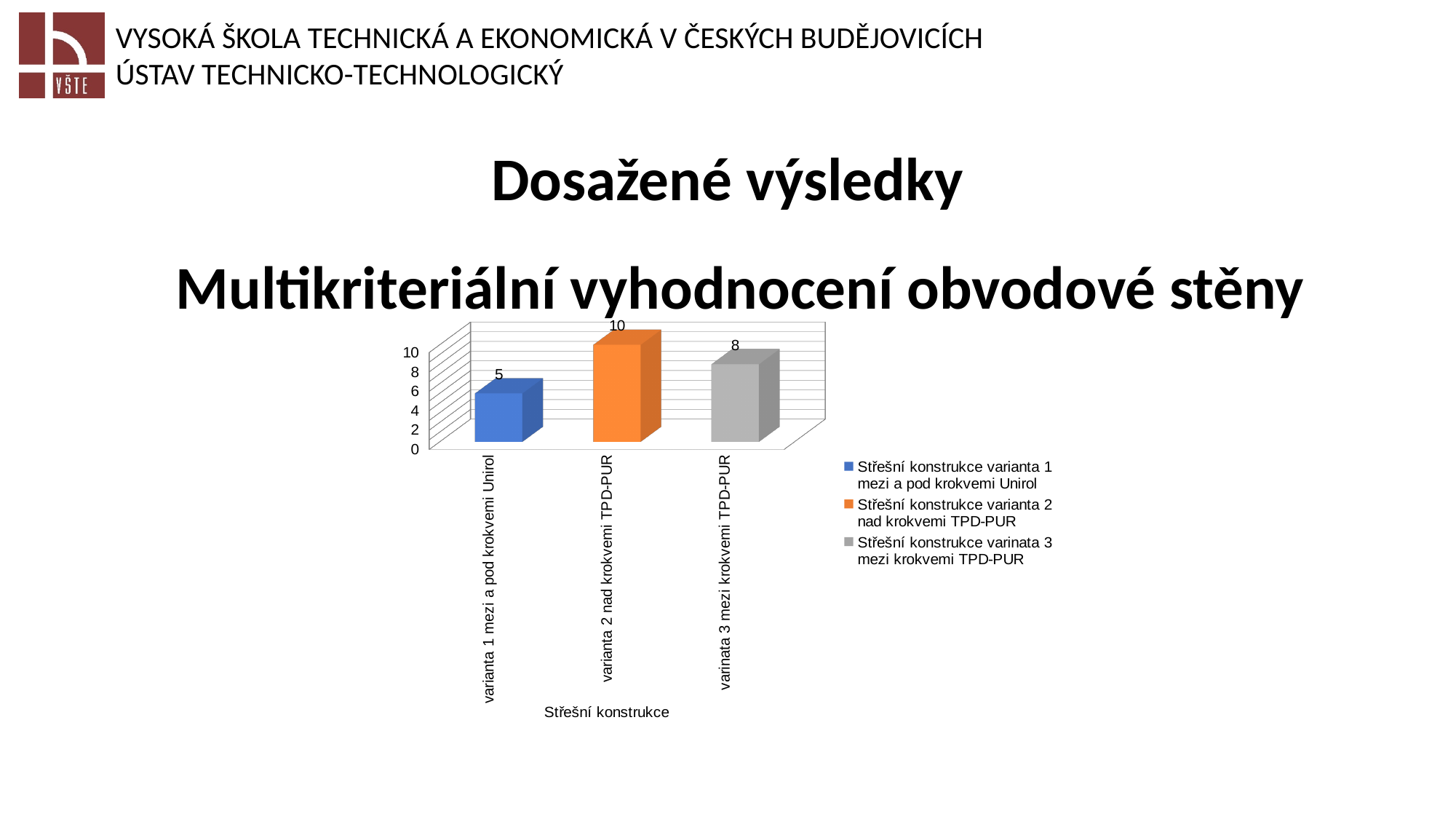
What is the difference between the values for varianta 2 nad krokvemi TPD-PUR and varianta 1 mezi a pod krokvemi Unirol? 5 What value is shown for varinata 3 mezi krokvemi TPD-PUR? 8 How many bars are plotted in the chart? 3 Which category has the highest value? varianta 2 nad krokvemi TPD-PUR Which category has the lowest value? varianta 1 mezi a pod krokvemi Unirol How many entries does the legend list? 3 What value is shown for varianta 1 mezi a pod krokvemi Unirol? 5 Which is larger, the value for varinata 3 mezi krokvemi TPD-PUR or the value for varianta 1 mezi a pod krokvemi Unirol? varinata 3 mezi krokvemi TPD-PUR What value is shown for varianta 2 nad krokvemi TPD-PUR? 10 What is the difference between the values for varianta 2 nad krokvemi TPD-PUR and varinata 3 mezi krokvemi TPD-PUR? 2 What is the title of the horizontal axis of the chart? Střešní konstrukce What kind of chart is shown on the slide? bar chart